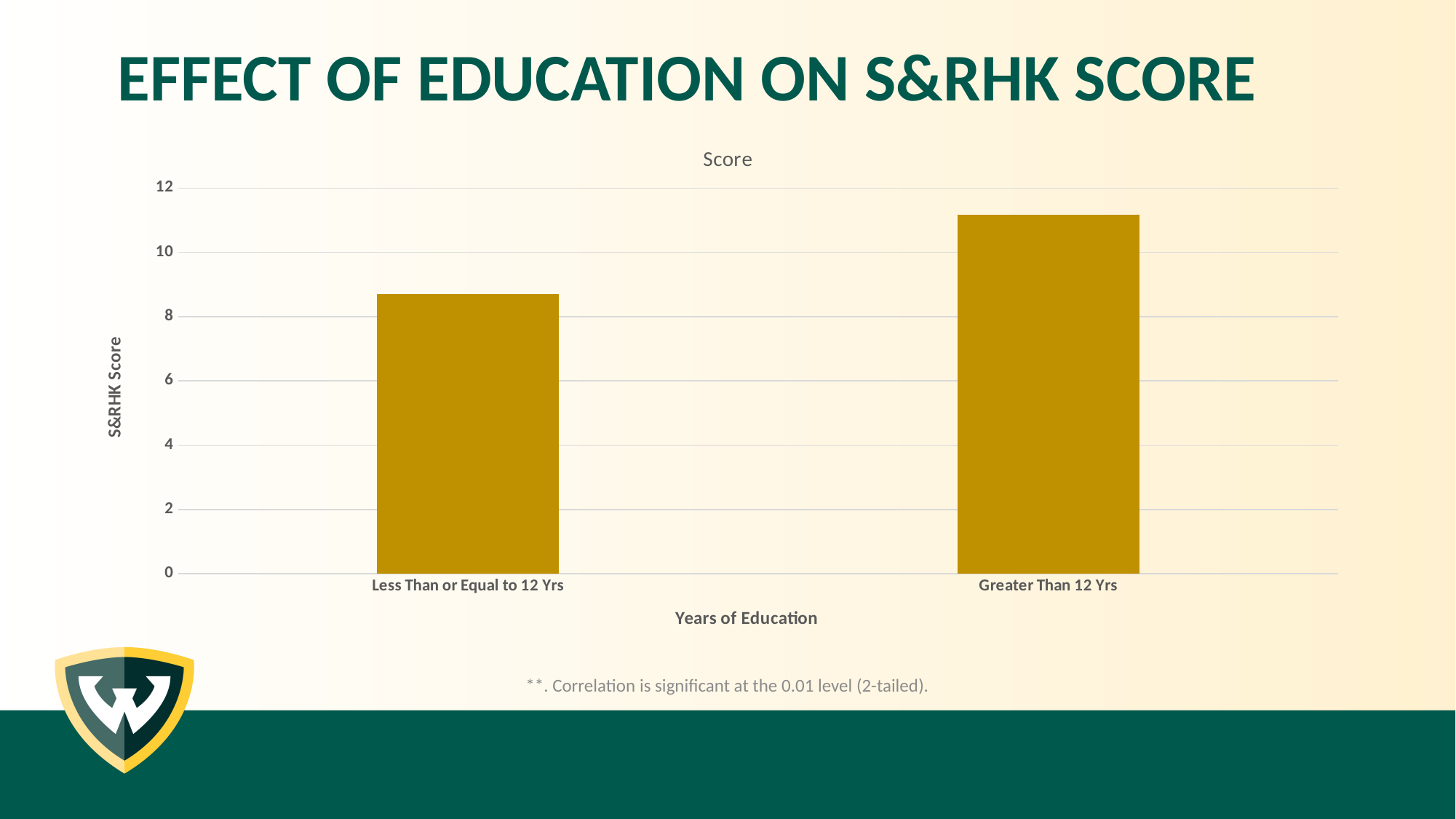
Do the values rise or fall moving from left to right along the x axis? rise What is the label of the y axis? S&RHK Score What kind of chart is shown on the slide? bar chart What is the label of the x axis? Years of Education Is the value for Less Than or Equal to 12 Yrs greater or less than 8? greater Which has a larger S&RHK Score: Less Than or Equal to 12 Yrs or Greater Than 12 Yrs? Greater Than 12 Yrs Which category has the highest S&RHK Score? Greater Than 12 Yrs Is the value for Greater Than 12 Yrs greater or less than 10? greater How many categories are plotted on the x axis? 2 Is the value for Greater Than 12 Yrs greater or less than 12? less Which category has the lowest S&RHK Score? Less Than or Equal to 12 Yrs